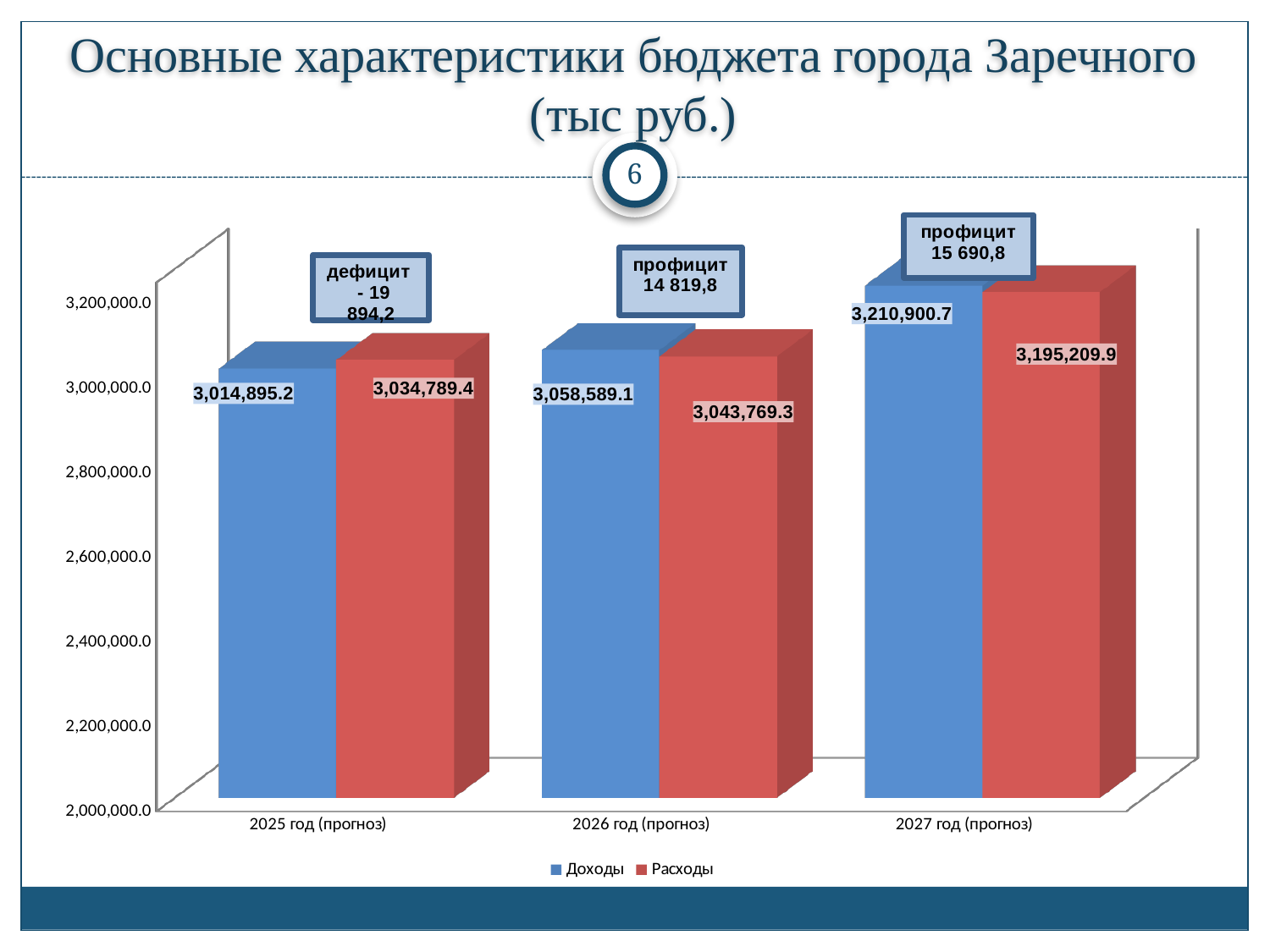
How many series does the legend list? 2 What is the difference between Доходы and Расходы for 2027 год (прогноз)? 15,690.8 For 2026 год (прогноз), which is larger: Доходы or Расходы? Доходы What is the value of Расходы for 2026 год (прогноз)? 3,043,769.3 What is the difference between Расходы and Доходы for 2025 год (прогноз)? 19,894.2 What is the value of Доходы for 2025 год (прогноз)? 3,014,895.2 Is the value of Доходы for 2027 год (прогноз) greater or less than 3,200,000.0? greater How many year categories are shown on the x axis? 3 Do the values for Доходы rise or fall from 2025 to 2027? rise Which year has the highest value for Доходы? 2027 год (прогноз) What is the value of Расходы for 2027 год (прогноз)? 3,195,209.9 Which year has the lowest value for Расходы? 2025 год (прогноз)